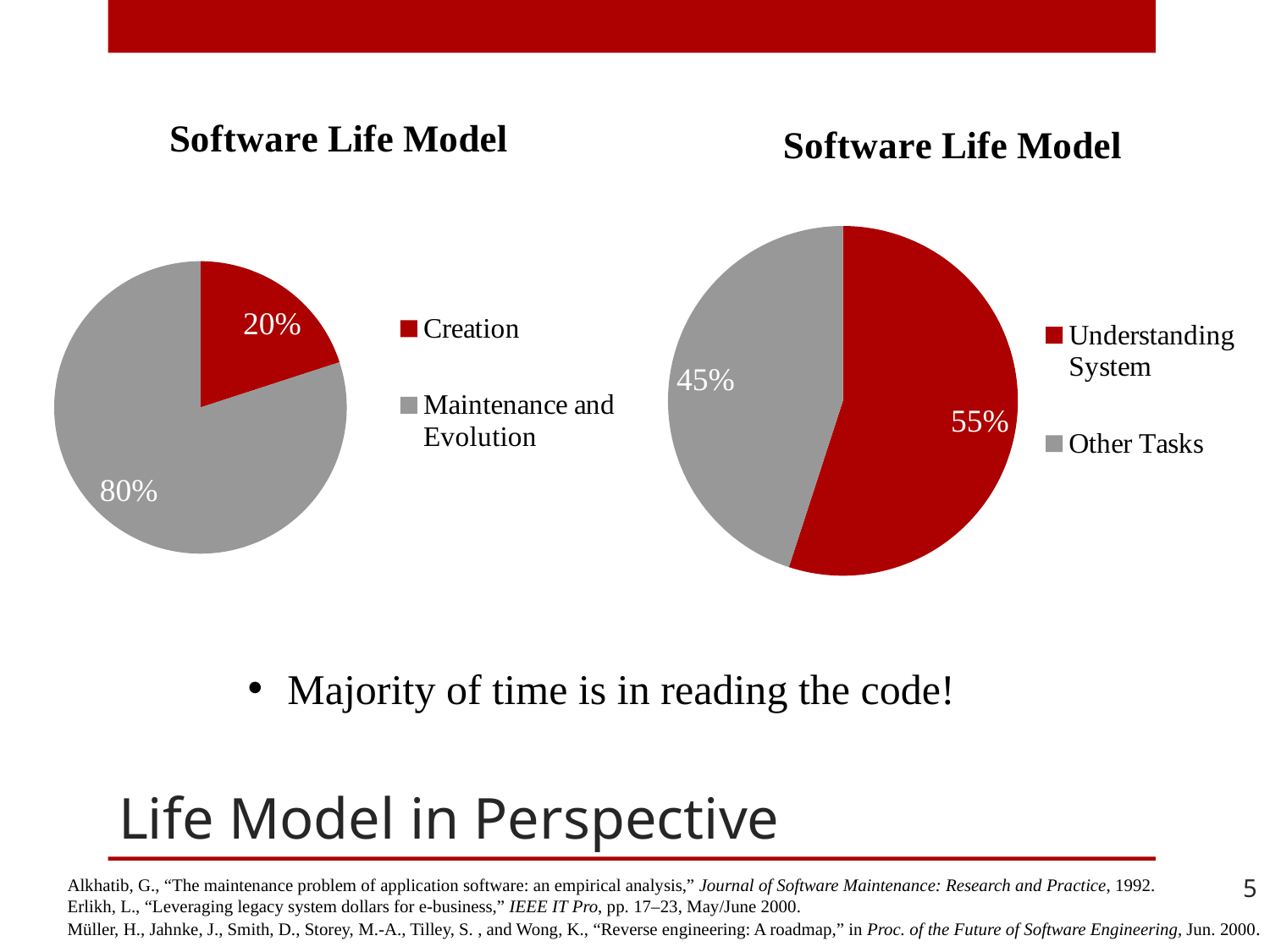
In the left pie chart, what is the difference between the Maintenance and Evolution share and the Creation share? 60% What kind of chart is the left chart on the slide? Pie chart How many slices does the right pie chart have? 2 In the right pie chart, what share is labelled for Other Tasks? 45% In the left pie chart, what share is labelled for Maintenance and Evolution? 80% In the left pie chart, what colour is the Creation slice? Red In the right pie chart, which is larger: Understanding System or Other Tasks? Understanding System In the left pie chart, what share is labelled for Creation? 20% In the right pie chart, what share is labelled for Understanding System? 55% In the right pie chart, what is the difference between the Understanding System share and the Other Tasks share? 10% In the left pie chart, which slice is the largest? Maintenance and Evolution In the right pie chart, which slice is the smallest? Other Tasks